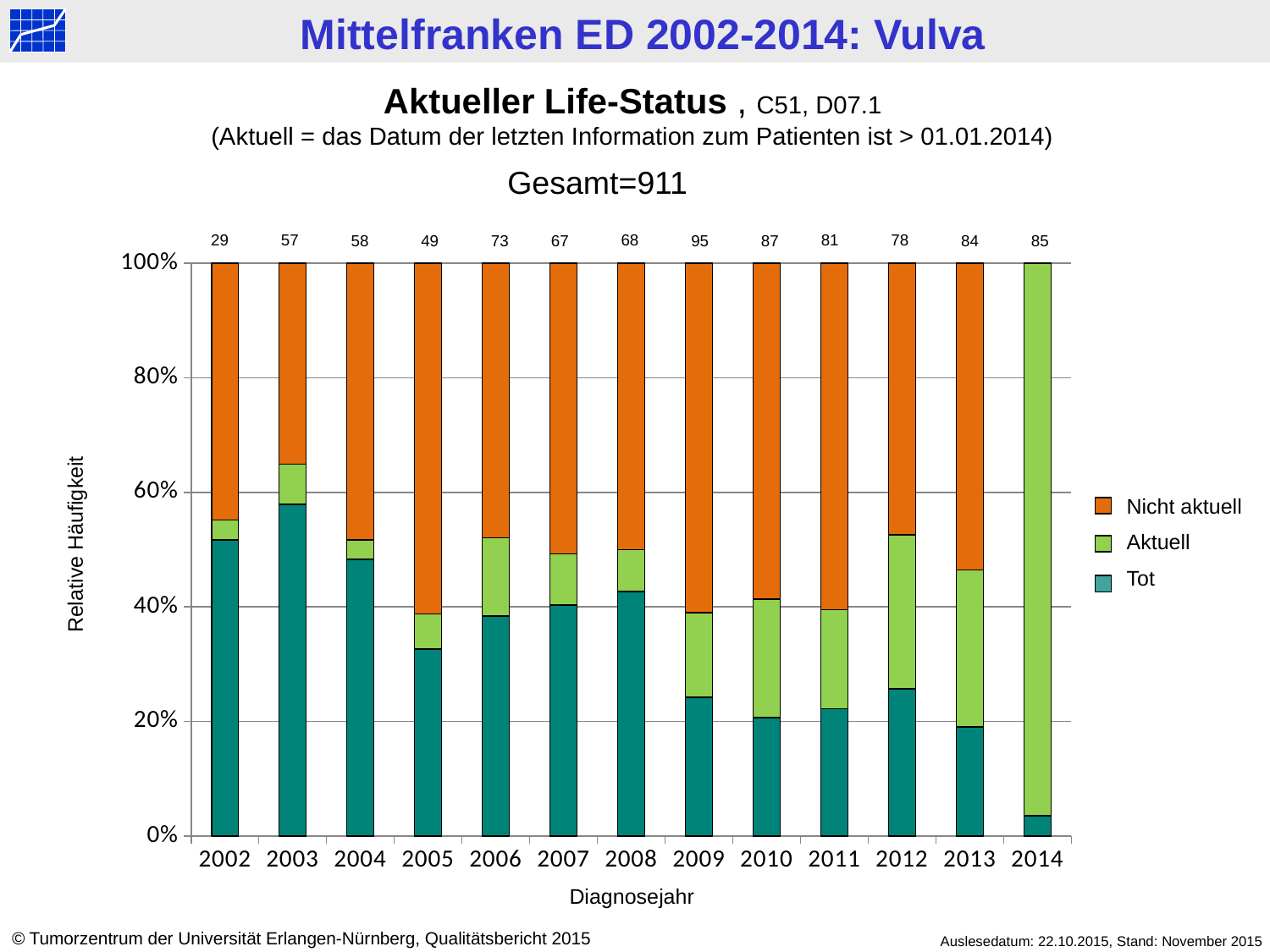
What is the number printed above the bar for 2002? 29 How many series does the legend list? 3 Which has the larger number printed above its bar, 2006 or 2005? 2006 Which diagnosis year has the highest number printed above its bar? 2009 Is the share of 'Tot' in 2002 greater or less than 40%? greater Which diagnosis year has the lowest number printed above its bar? 2002 How many diagnosis years (categories) are shown on the x axis? 13 What kind of chart is shown on the slide? bar chart What is the total number of cases (Gesamt) stated on the slide? 911 What is the number printed above the bar for 2009? 95 What is the difference between the numbers printed above the bars for 2009 and 2002? 66 What is the number printed above the bar for 2014? 85